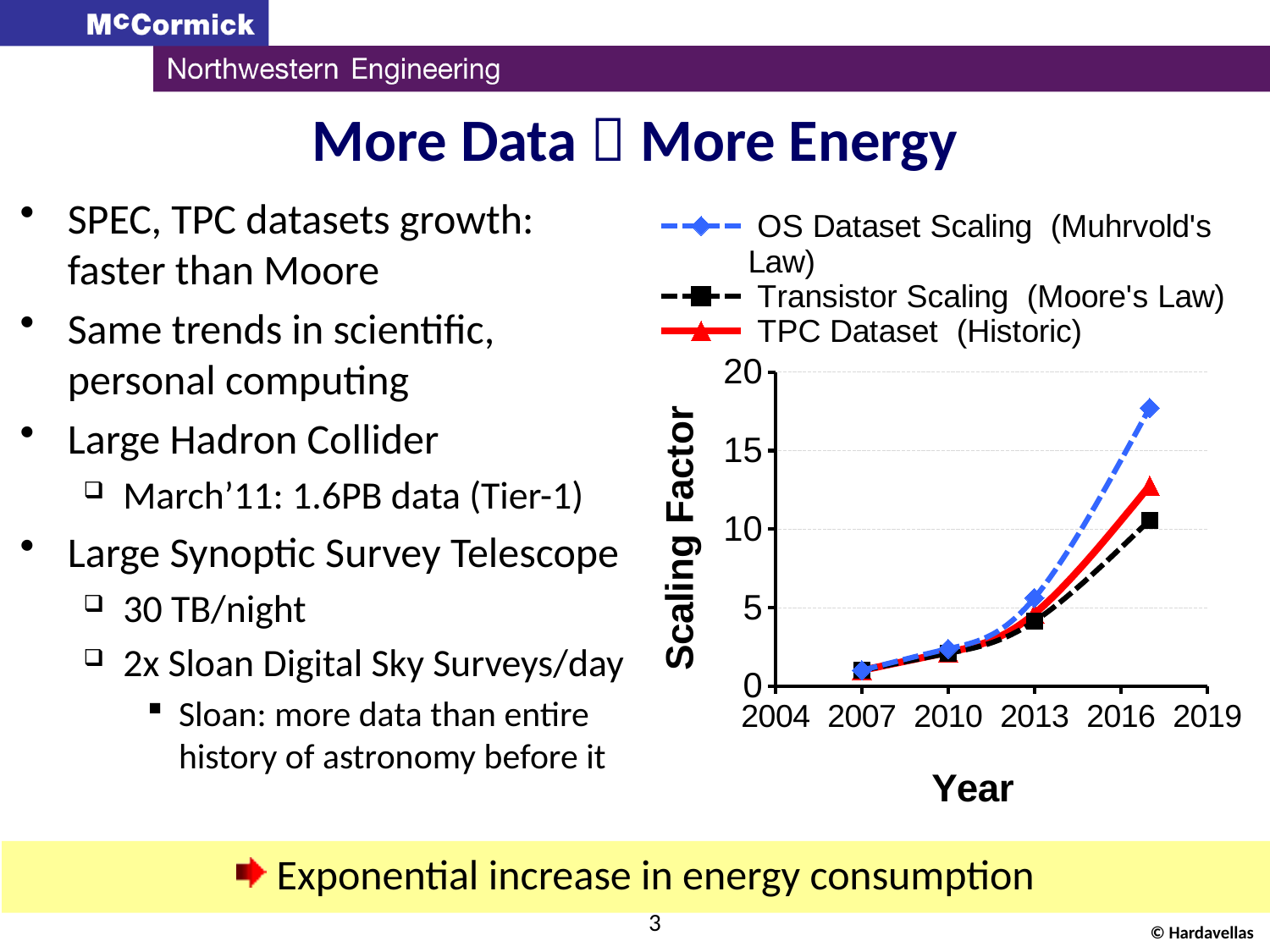
How many data points are plotted for each series in the chart? 4 Do the values of the Transistor Scaling (Moore's Law) series rise or fall along the x axis? rise Do the values of the OS Dataset Scaling series rise or fall as the year increases? rise Is the value of the OS Dataset Scaling series at its last plotted point greater or less than 15? greater What kind of chart is shown on the slide? line chart Is the value of the TPC Dataset (Historic) series at its last plotted point greater or less than 15? less Which series has the lowest scaling factor at the last plotted year? Transistor Scaling (Moore's Law) Which series has the highest scaling factor at the last plotted year? OS Dataset Scaling (Muhrvold's Law) What is the title of the chart's vertical axis? Scaling Factor How many series does the chart's legend list? 3 At the last plotted year, which is larger: the OS Dataset Scaling value or the Transistor Scaling value? OS Dataset Scaling What is the title of the chart's horizontal axis? Year